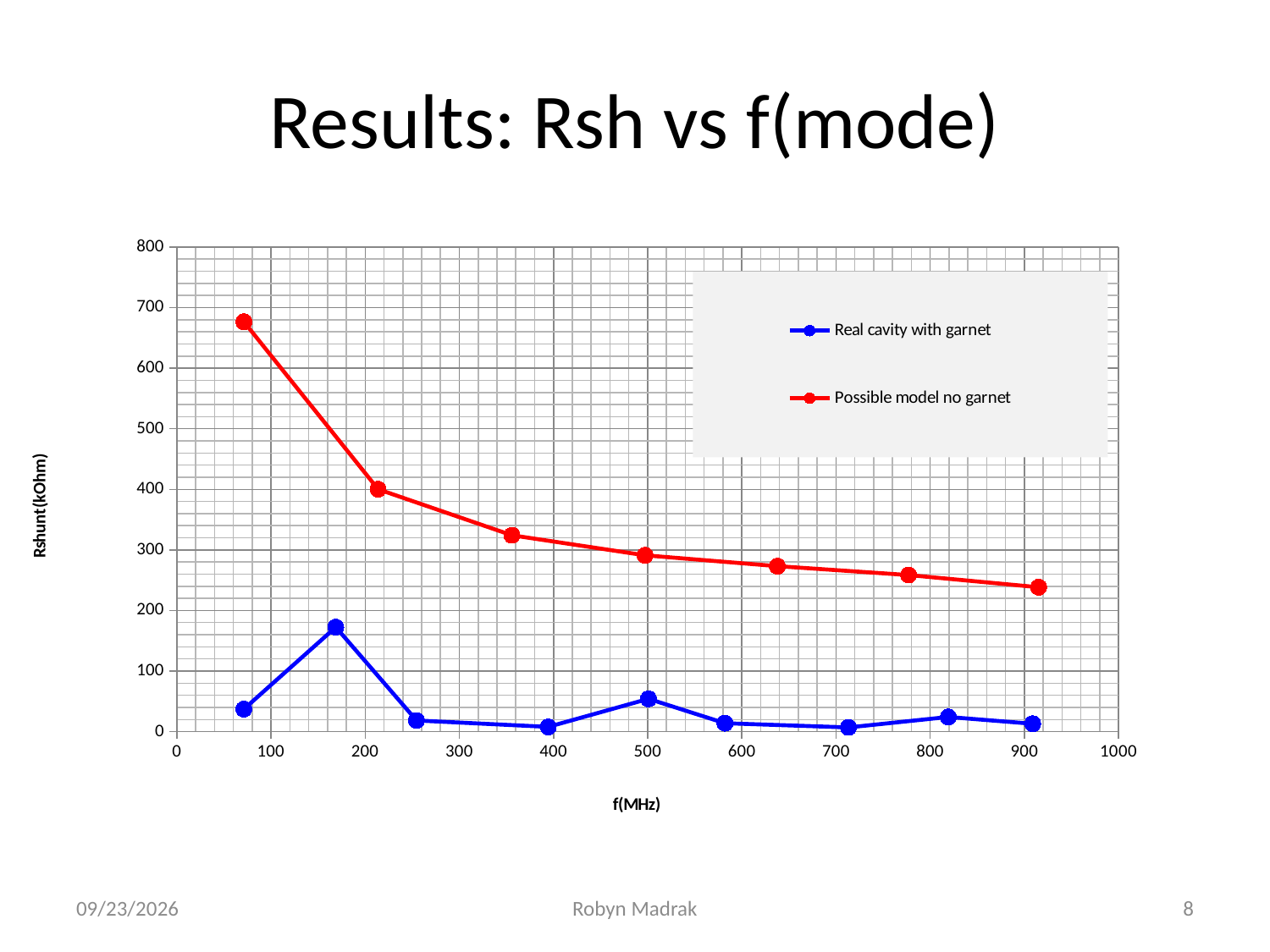
Is the value of the 'Real cavity with garnet' series at around 400 MHz greater or less than 100? less What kind of chart is shown on the slide? line chart Is the last (highest-frequency) value of the 'Possible model no garnet' series greater or less than 200? greater How many data points are plotted for the 'Real cavity with garnet' series? 9 What is the title of the chart? Results: Rsh vs f(mode) Is the highest value of the 'Real cavity with garnet' series greater or less than 200? less How many series does the legend list? 2 How many data points are plotted for the 'Possible model no garnet' series? 7 What is the label of the vertical axis? Rshunt (kOhm) Which series has the larger value at around 500 MHz, 'Real cavity with garnet' or 'Possible model no garnet'? Possible model no garnet Do the values of the 'Possible model no garnet' series rise or fall as frequency increases along the x axis? fall